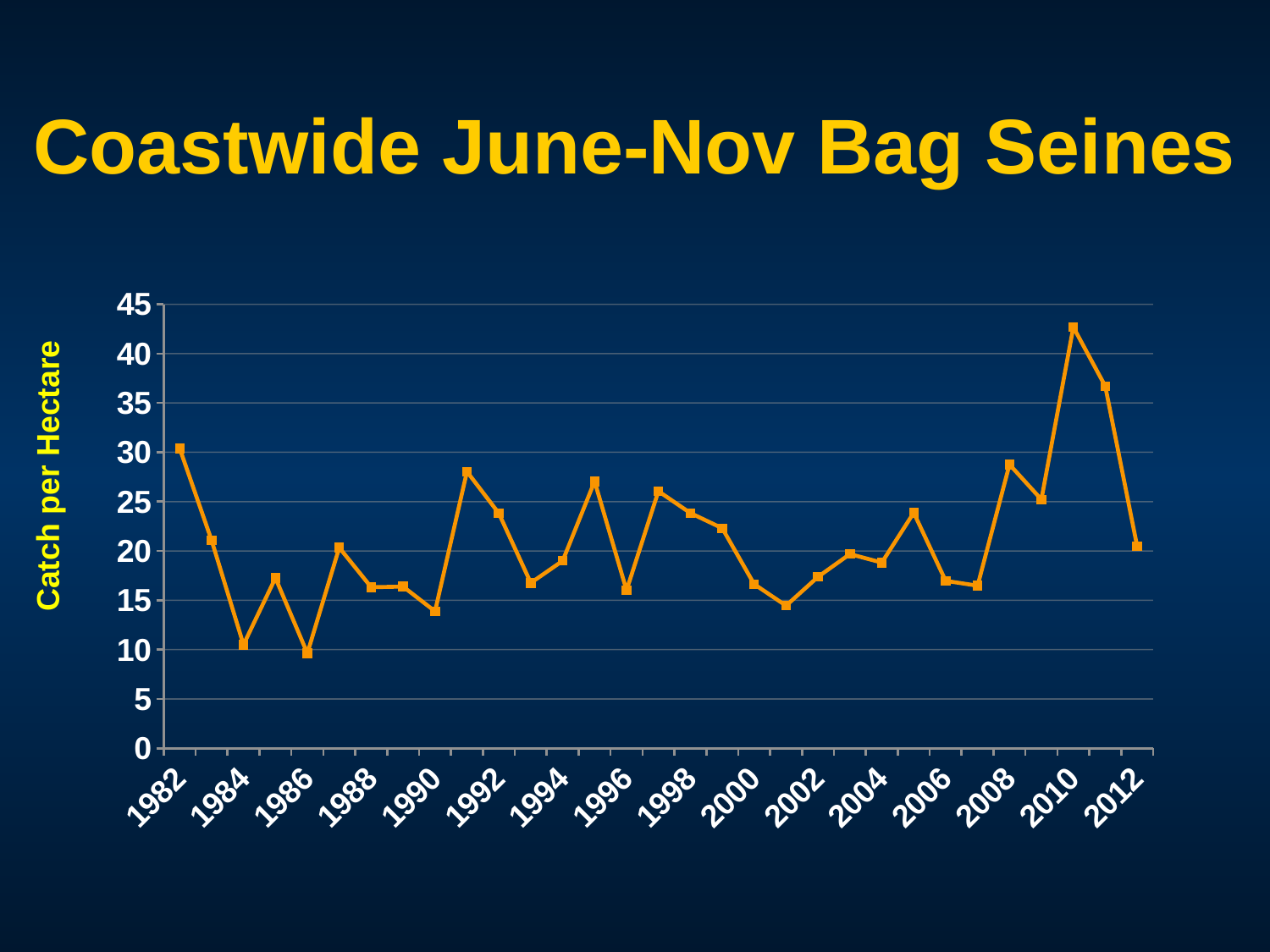
Which year has the larger catch per hectare, 2010 or 1982? 2010 Is the value for 1991 greater or less than 25? greater Is the value for 2001 greater or less than 20? less How many yearly data points are plotted on the chart? 31 Which year has the highest catch per hectare? 2010 Do the values rise or fall from 2010 to 2012? fall What kind of chart is shown on the slide? line chart Is the value for 2012 greater or less than 25? less Which year has the larger catch per hectare, 1991 or 1996? 1991 What is the label on the vertical axis? Catch per Hectare